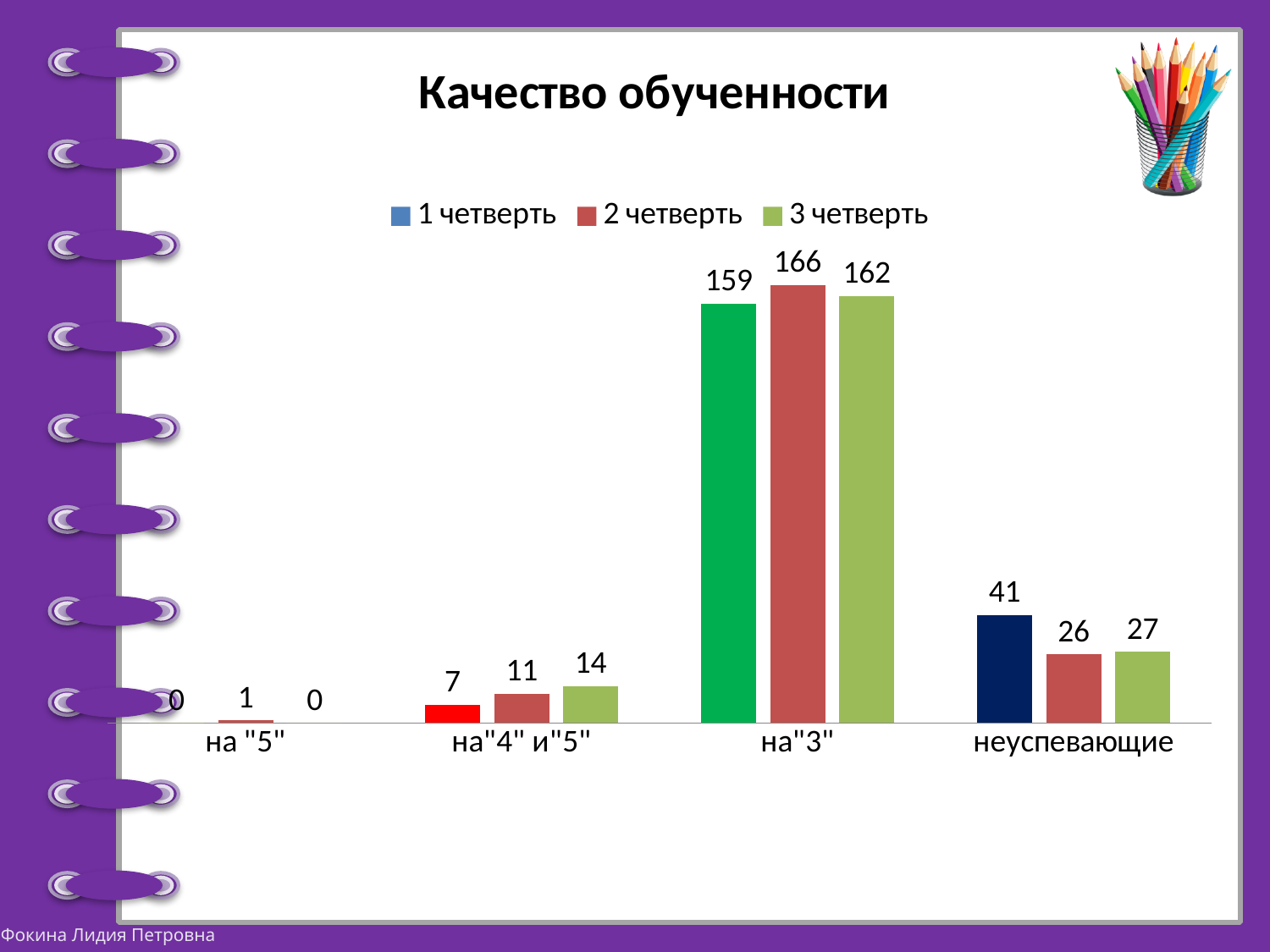
What is the value for "2 четверть" in the category на"3"? 166 What is the value for "3 четверть" in the category на"4" и"5"? 14 In the category на"4" и"5", which is larger: the value for "1 четверть" or for "3 четверть"? 3 четверть What is the difference between the "1 четверть" and "2 четверть" values in the category неуспевающие? 15 Which category has the lowest value for "1 четверть"? на "5" How many categories are shown on the x axis? 4 How many series does the legend list? 3 What is the value for "1 четверть" in the category неуспевающие? 41 What is the value for "2 четверть" in the category на "5"? 1 Which category has the highest value for "3 четверть"? на"3" What is the difference between the "2 четверть" and "1 четверть" values in the category на"3"? 7 What kind of chart is shown on the slide? bar chart